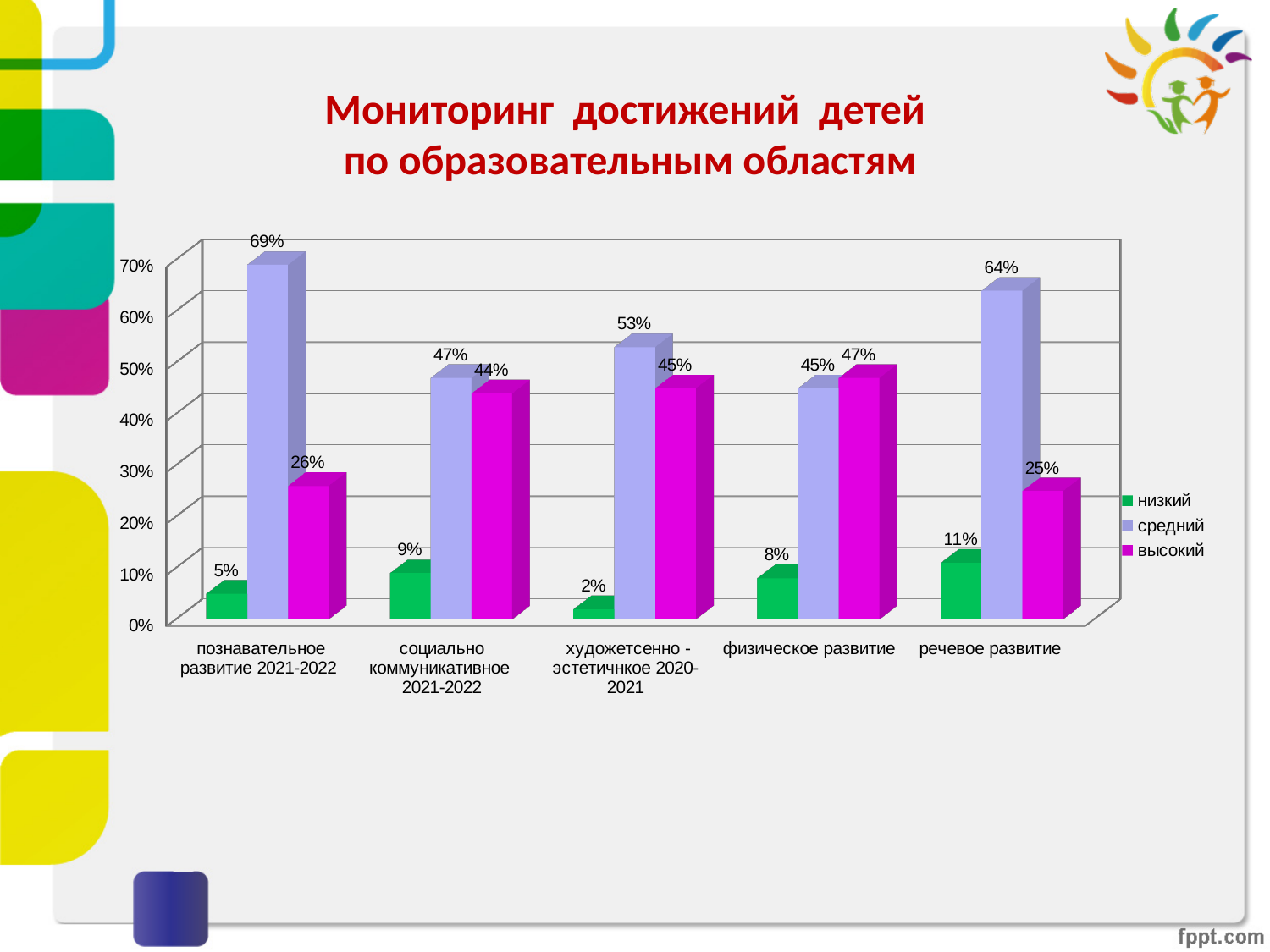
What kind of chart is shown on the slide? bar chart What is the total of the three series values for физическое развитие? 100% Which category has the highest value in the средний series? познавательное развитие 2021-2022 What is the value of the высокий series for физическое развитие? 47% What is the value of the средний series for познавательное развитие 2021-2022? 69% Which category has the lowest value in the низкий series? художетсенно - эстетичнкое 2020-2021 What is the value of the низкий series for речевое развитие? 11% For социально коммуникативное 2021-2022, which is larger: the средний value or the высокий value? средний What is the difference between the средний and высокий values for речевое развитие? 39% How many series does the legend list? 3 How many categories are shown on the x axis? 5 Which colour represents the высокий series in the legend? magenta